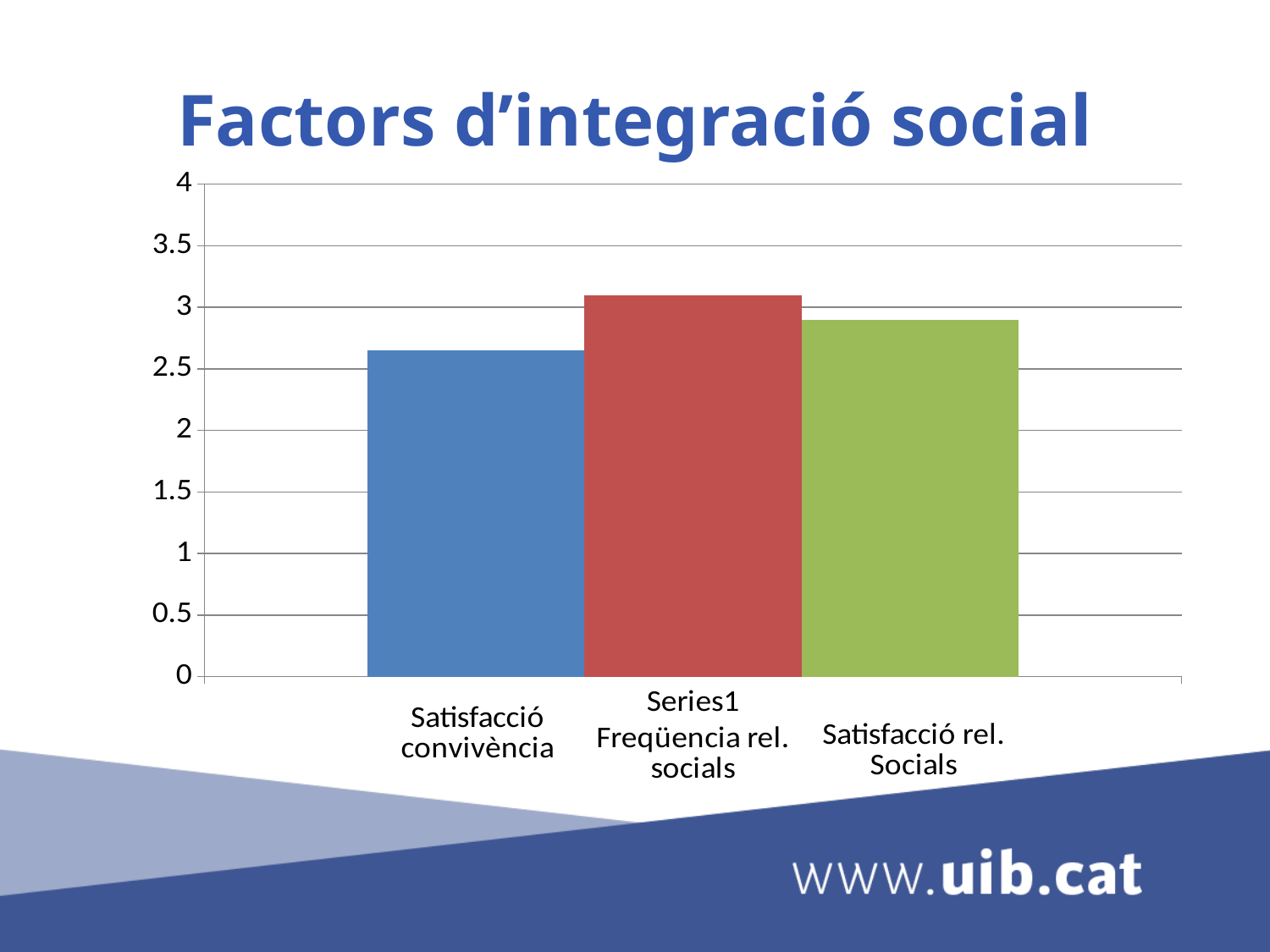
How many categories are plotted in the chart? 3 Which category has the highest value? Freqüencia rel. socials Which is larger, the value for Satisfacció rel. Socials or the value for Satisfacció convivència? Satisfacció rel. Socials Which category has the lowest value? Satisfacció convivència What kind of chart is shown on the slide? bar chart Which is larger, the value for Satisfacció convivència or the value for Freqüencia rel. socials? Freqüencia rel. socials Is the value for Satisfacció convivència greater or less than 3? less What is the title of the chart? Factors d'integració social Is the value for Freqüencia rel. socials greater or less than 3? greater Is the value for Satisfacció rel. Socials greater or less than 2.5? greater